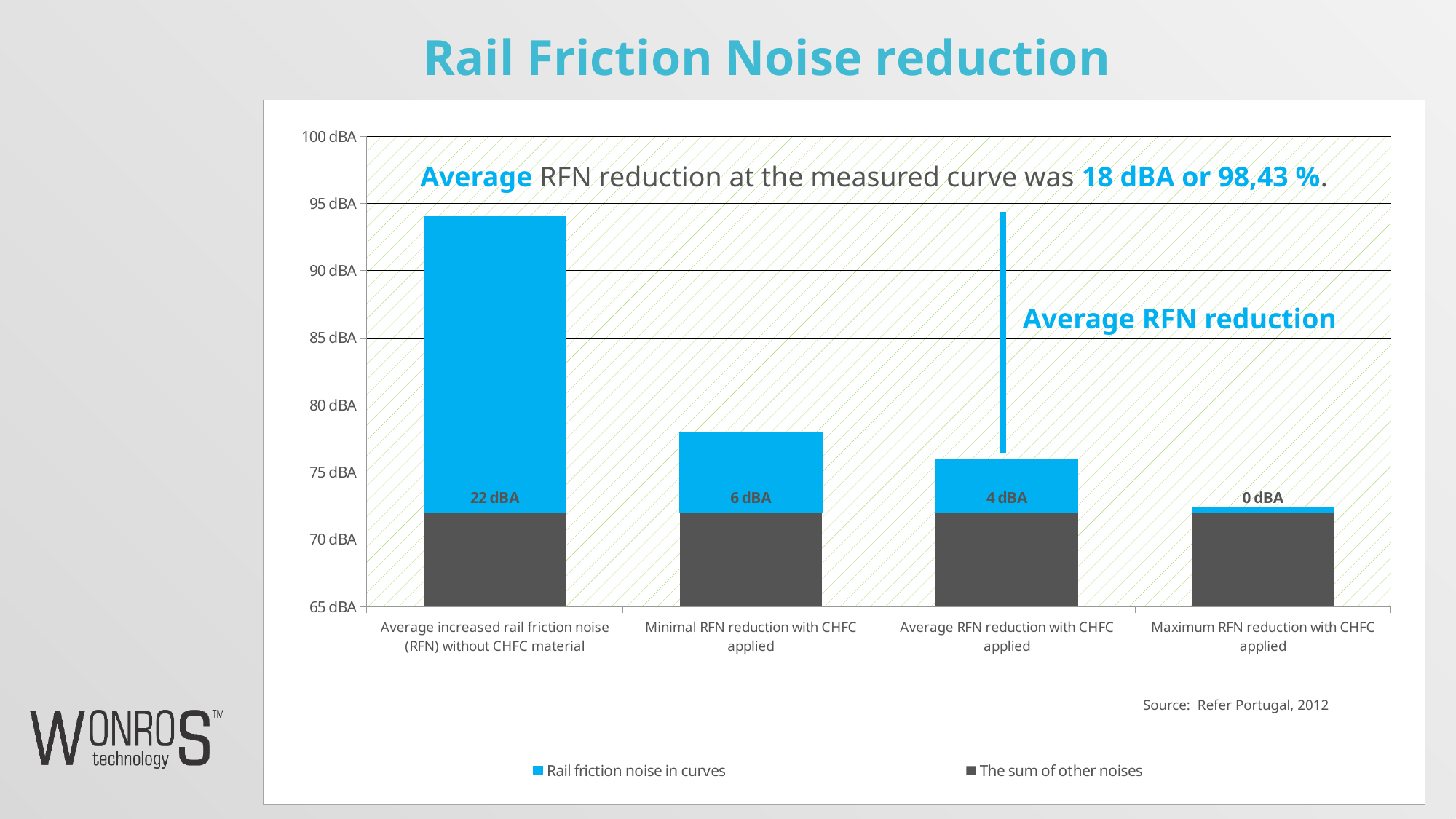
What is the difference in Rail friction noise in curves between 'Average increased rail friction noise (RFN) without CHFC material' and 'Minimal RFN reduction with CHFC applied'? 16 dBA What is the value of Rail friction noise in curves for 'Average increased rail friction noise (RFN) without CHFC material'? 22 dBA What is the value of Rail friction noise in curves for 'Minimal RFN reduction with CHFC applied'? 6 dBA Which has the larger Rail friction noise in curves value: 'Minimal RFN reduction with CHFC applied' or 'Average RFN reduction with CHFC applied'? Minimal RFN reduction with CHFC applied Which category has the highest Rail friction noise in curves value? Average increased rail friction noise (RFN) without CHFC material What is the value of Rail friction noise in curves for 'Maximum RFN reduction with CHFC applied'? 0 dBA Is the total height of the stacked bar for 'Average increased rail friction noise (RFN) without CHFC material' greater or less than 90 dBA? greater Do the Rail friction noise in curves values rise or fall from left to right along the x axis? fall How many series does the chart legend list? 2 Which category has the lowest Rail friction noise in curves value? Maximum RFN reduction with CHFC applied How many categories are shown on the x axis of the chart? 4 What is the value of Rail friction noise in curves for 'Average RFN reduction with CHFC applied'? 4 dBA